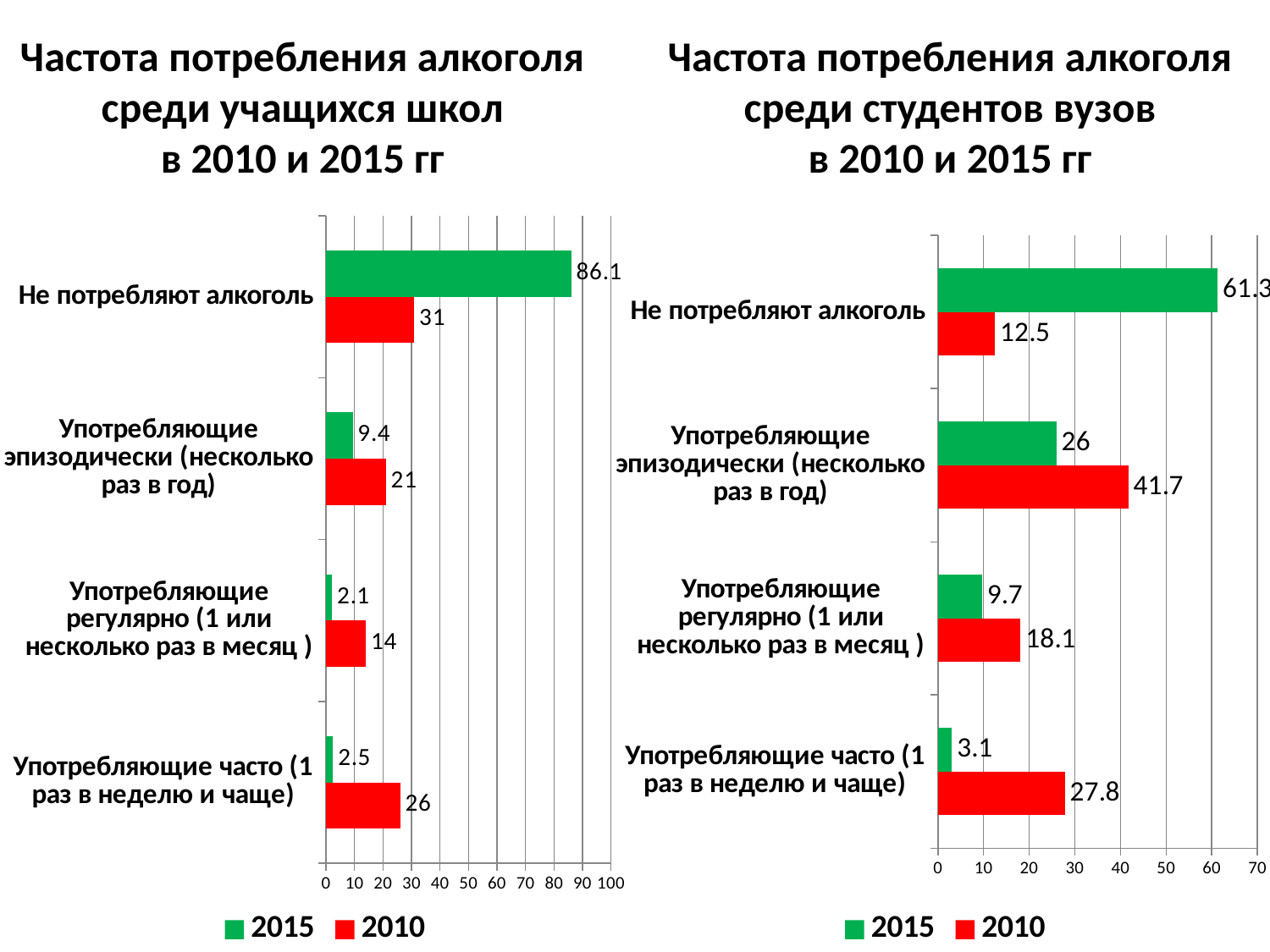
In the left chart (school students), what is the 2015 value for 'Не потребляют алкоголь'? 86.1 In the right chart (university students), what is the difference between the 2010 and 2015 values for 'Употребляющие часто (1 раз в неделю и чаще)'? 24.7 In the right chart (university students), which is larger for 'Употребляющие эпизодически (несколько раз в год)': the 2015 value or the 2010 value? 2010 What type of chart is the left chart (school students)? Bar chart How many series does the legend of the right chart (university students) list? 2 How many categories are shown in the left chart (school students)? 4 In the right chart (university students), what is the 2010 value for 'Употребляющие эпизодически (несколько раз в год)'? 41.7 In the right chart (university students), what is the 2015 value for 'Употребляющие регулярно (1 или несколько раз в месяц)'? 9.7 In the left chart (school students), what is the difference between the 2015 and 2010 values for 'Не потребляют алкоголь'? 55.1 In the left chart (school students), what is the 2010 value for 'Употребляющие часто (1 раз в неделю и чаще)'? 26 In the left chart (school students), which category has the highest 2010 value? Не потребляют алкоголь In the right chart (university students), which category has the lowest 2015 value? Употребляющие часто (1 раз в неделю и чаще)